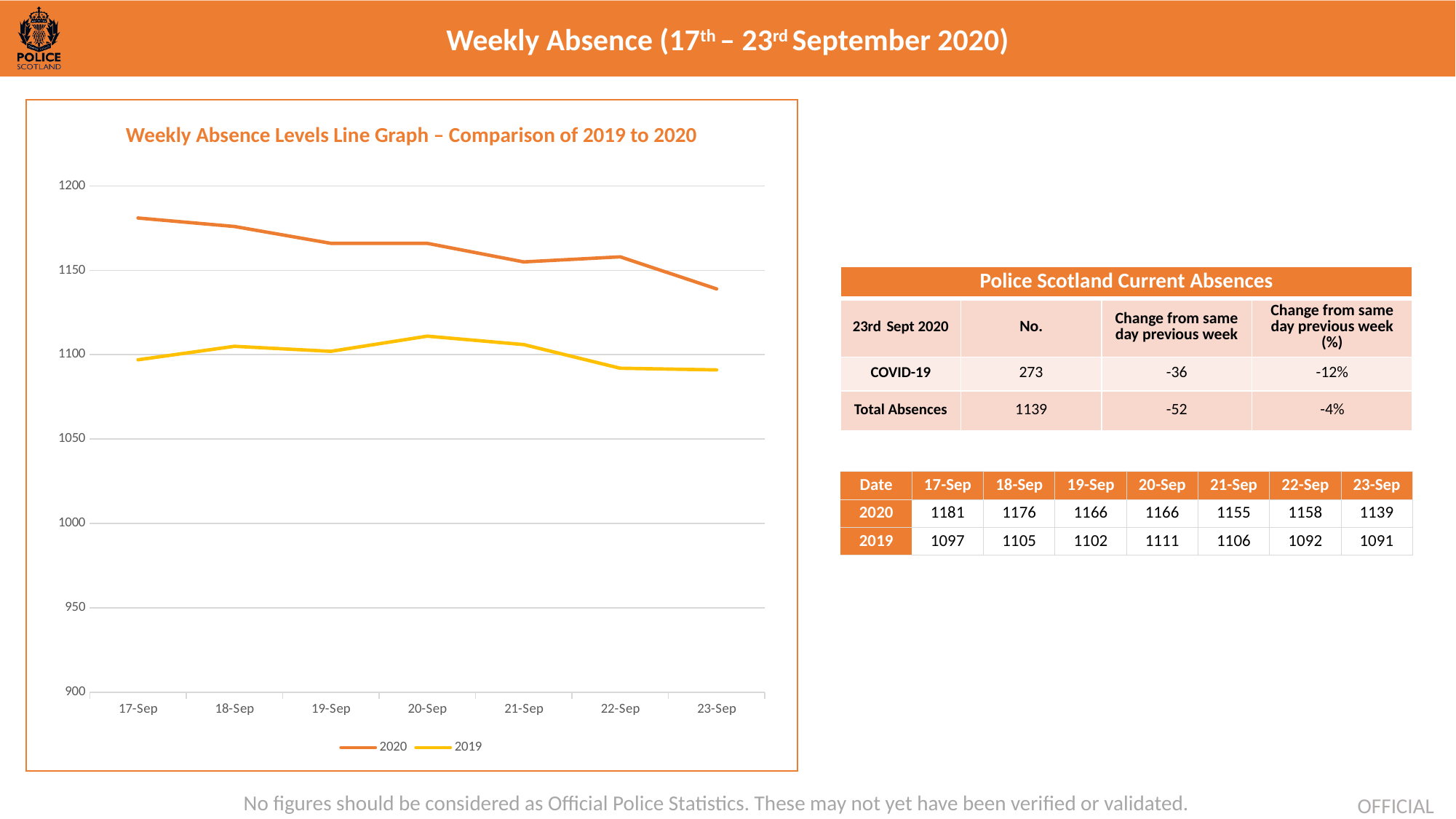
On which date is the 2020 series at its lowest? 23-Sep How many dates are plotted along the x axis of the chart? 7 Which series has the higher value on 21-Sep, 2020 or 2019? 2020 What is the 2020 absence value for 17-Sep? 1181 What colour is the 2019 line in the chart? yellow On which date is the 2019 series at its highest? 20-Sep How many series does the chart legend list? 2 What kind of chart is shown on the slide? line chart What is the difference between the 2020 and 2019 values on 23-Sep? 48 Is the 2020 value for 17-Sep greater or less than 1150? greater Does the 2020 series generally rise or fall from 17-Sep to 23-Sep? fall What is the 2019 absence value for 20-Sep? 1111